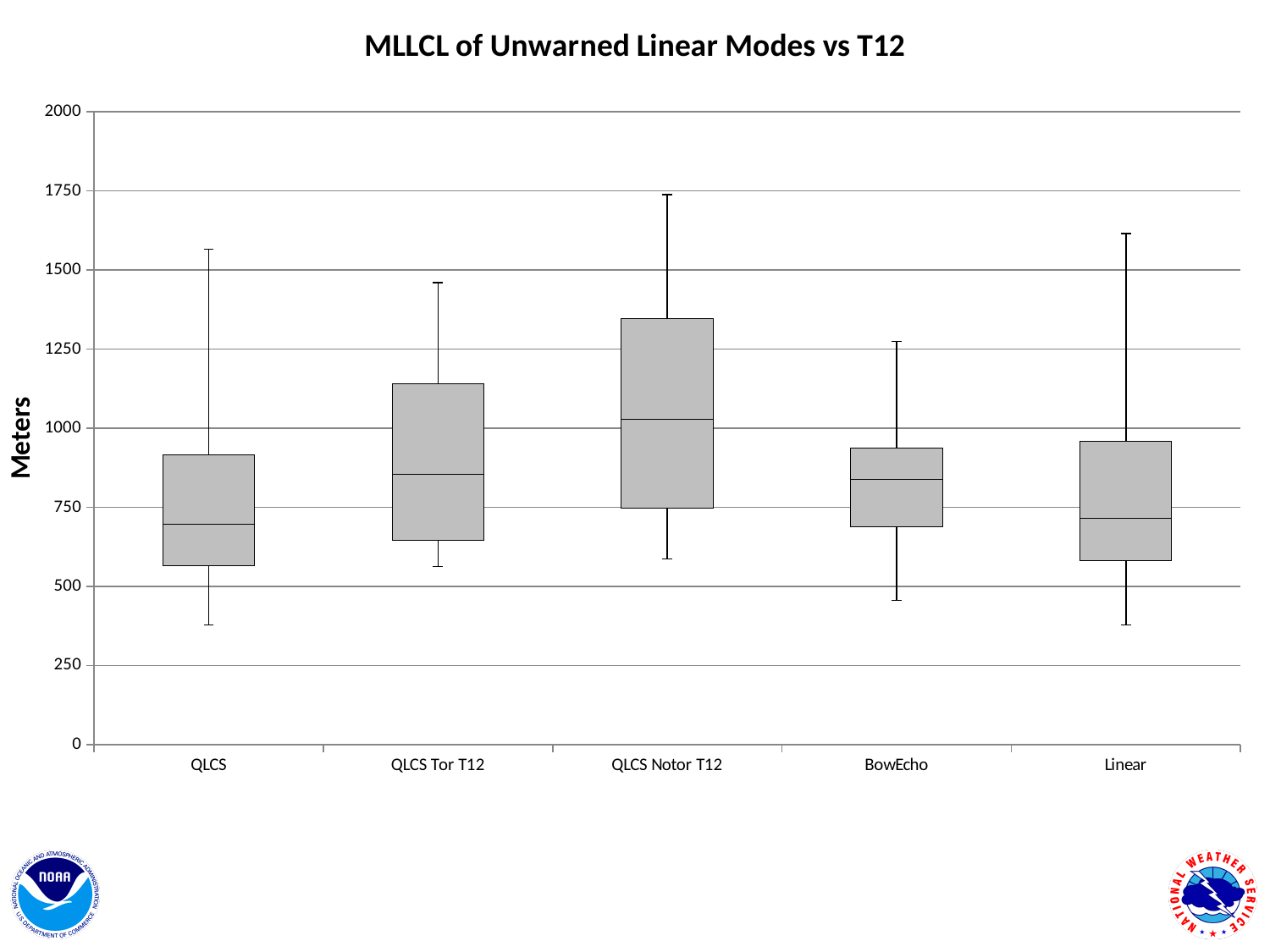
Which category has the highest median value? QLCS Notor T12 What kind of chart is shown on the slide? Box-and-whisker plot Is the upper whisker for Linear greater or less than 1500? greater What is the title of the chart? MLLCL of Unwarned Linear Modes vs T12 Which has the larger median value, QLCS Notor T12 or BowEcho? QLCS Notor T12 How many categories are shown along the x axis? 5 Which has the larger median value, QLCS Tor T12 or QLCS? QLCS Tor T12 Is the median value for QLCS greater or less than 750? less Is the lower whisker for BowEcho greater or less than 500? less Which category has the highest upper whisker (maximum value)? QLCS Notor T12 What is the label on the vertical axis? Meters